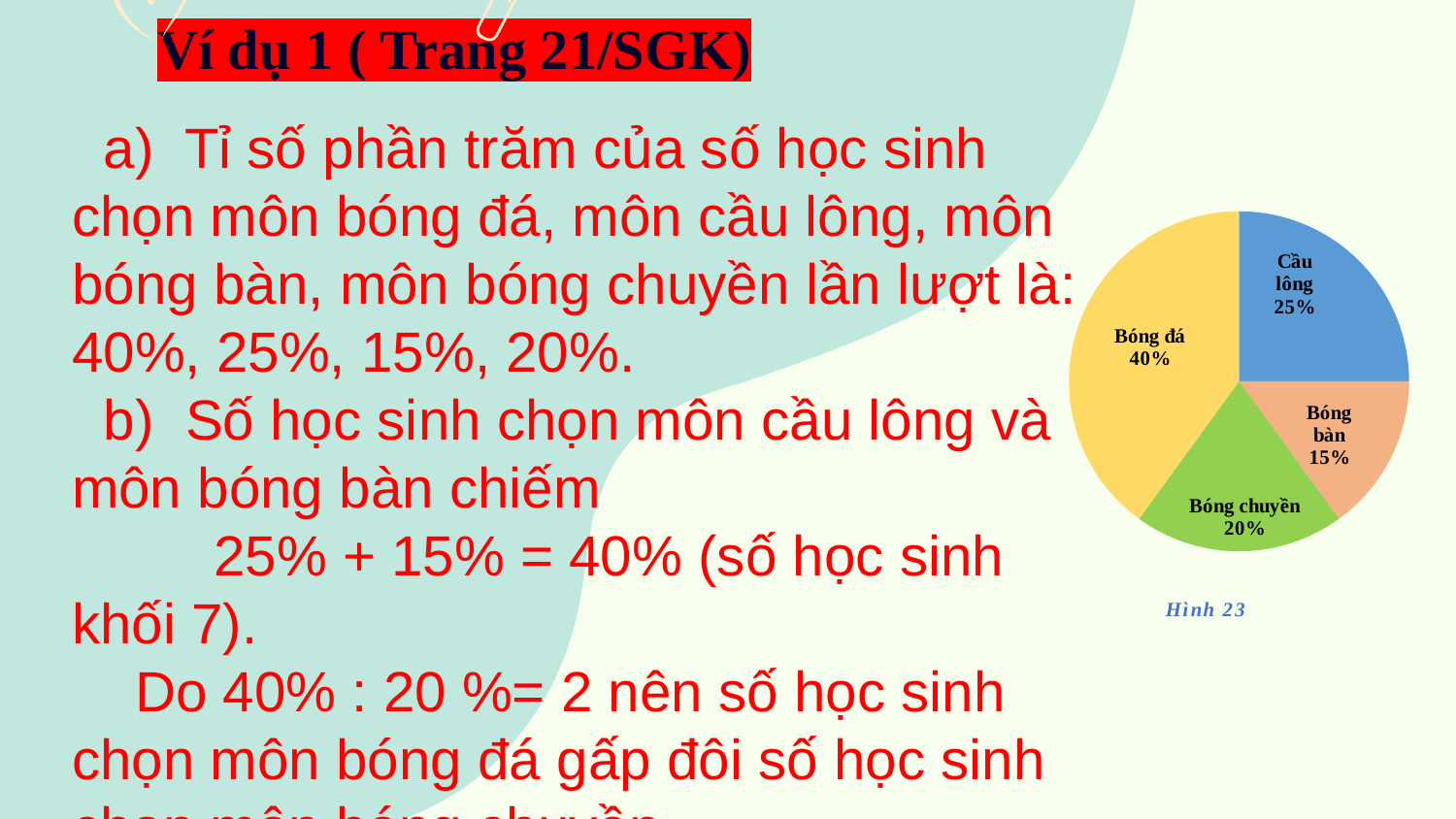
What is the difference in percentage points between Bóng đá and Bóng chuyền? 20% Which category has the smallest slice in the pie chart? Bóng bàn What percentage of the pie chart is Bóng chuyền? 20% What is the combined share of Cầu lông and Bóng bàn in the pie chart? 40% What percentage of the pie chart is Bóng bàn? 15% What kind of chart is shown on the slide? pie chart Which category has the largest slice in the pie chart? Bóng đá What percentage of the pie chart is Bóng đá? 40% What is the caption written below the pie chart? Hình 23 What percentage of the pie chart is Cầu lông? 25% How many slices does the pie chart have? 4 Which is larger in the pie chart, Cầu lông or Bóng bàn? Cầu lông